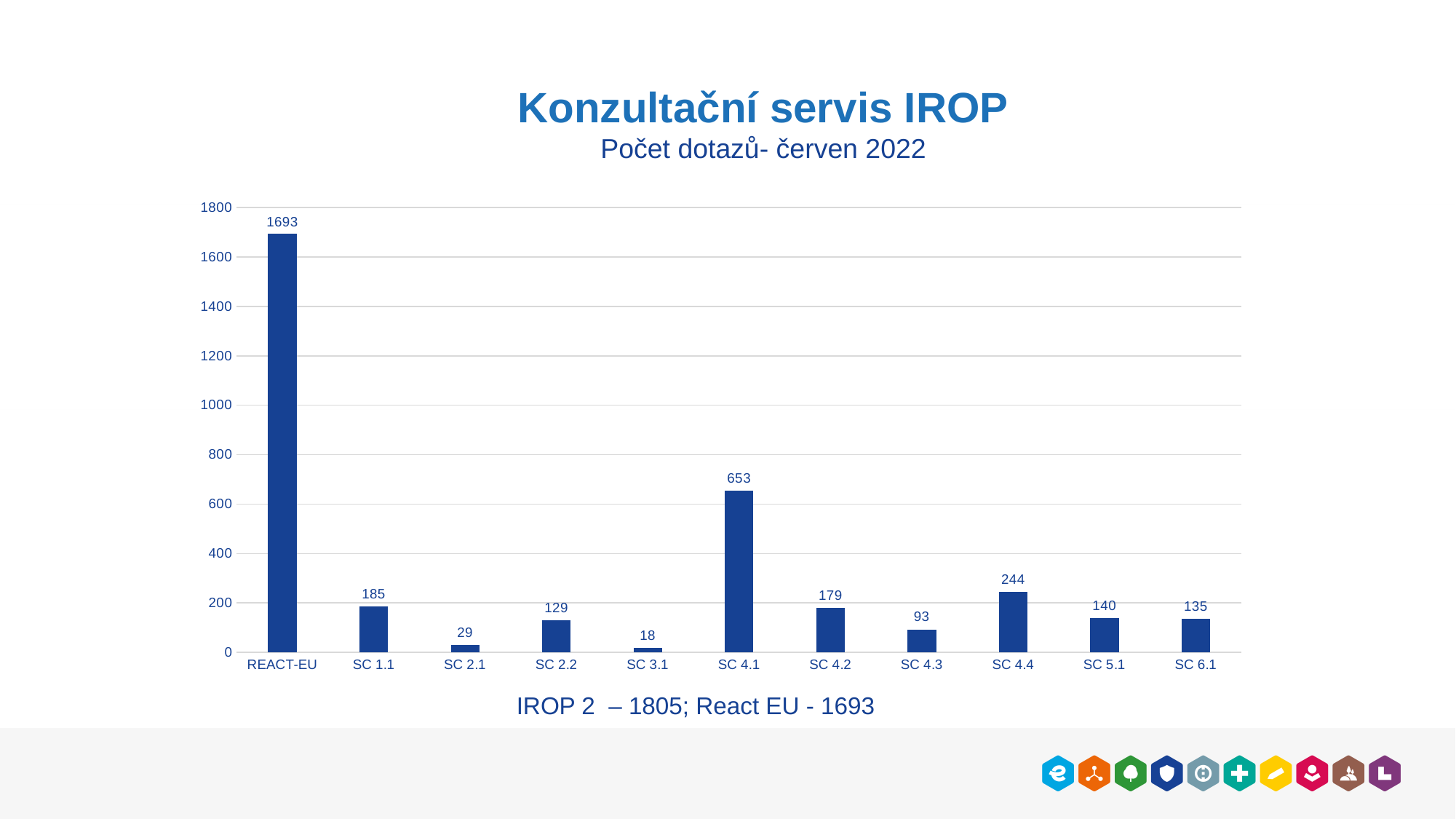
What is the value for SC 4.1? 653 What is the title of the chart? Konzultační servis IROP Which is larger, the value for SC 1.1 or the value for SC 4.2? SC 1.1 What kind of chart is shown on the slide? bar chart Is the value for SC 4.1 greater or less than 600? greater What is the value for SC 4.4? 244 Which category has the highest value? REACT-EU What is the value for REACT-EU? 1693 What is the difference between the values for SC 5.1 and SC 6.1? 5 Which category has the lowest value? SC 3.1 What is the difference between the values for SC 4.1 and SC 4.4? 409 How many categories are shown on the x axis? 11